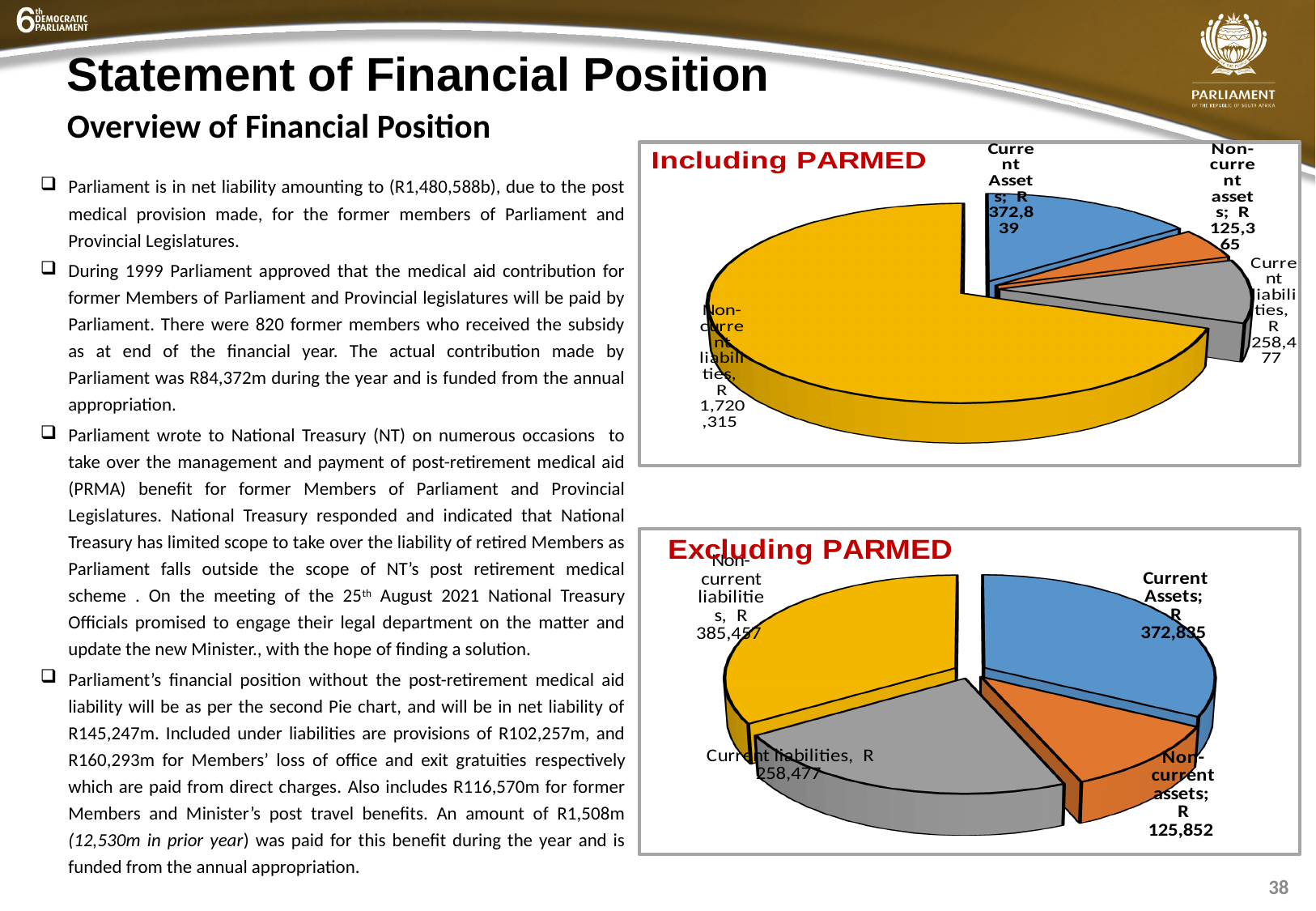
In the 'Including PARMED' chart, what is the value for Current liabilities? R 258,477 In the 'Including PARMED' chart, what is the value for Non-current liabilities? R 1,720,315 In the 'Including PARMED' chart, which category has the largest slice? Non-current liabilities What type of chart is the 'Including PARMED' chart? Pie chart How many slices does the 'Excluding PARMED' pie chart have? 4 In the 'Excluding PARMED' chart, what is the difference between Current Assets and Non-current assets? R 246,983 In the 'Excluding PARMED' chart, which category has the smallest slice? Non-current assets In the 'Excluding PARMED' chart, what is the value for Non-current liabilities? R 385,457 In the 'Excluding PARMED' chart, what is the value for Current Assets? R 372,835 In the 'Including PARMED' chart, which category has the smallest slice? Non-current assets In the 'Excluding PARMED' chart, what is the value for Non-current assets? R 125,852 In the 'Excluding PARMED' chart, what colour is the Current Assets slice? Blue